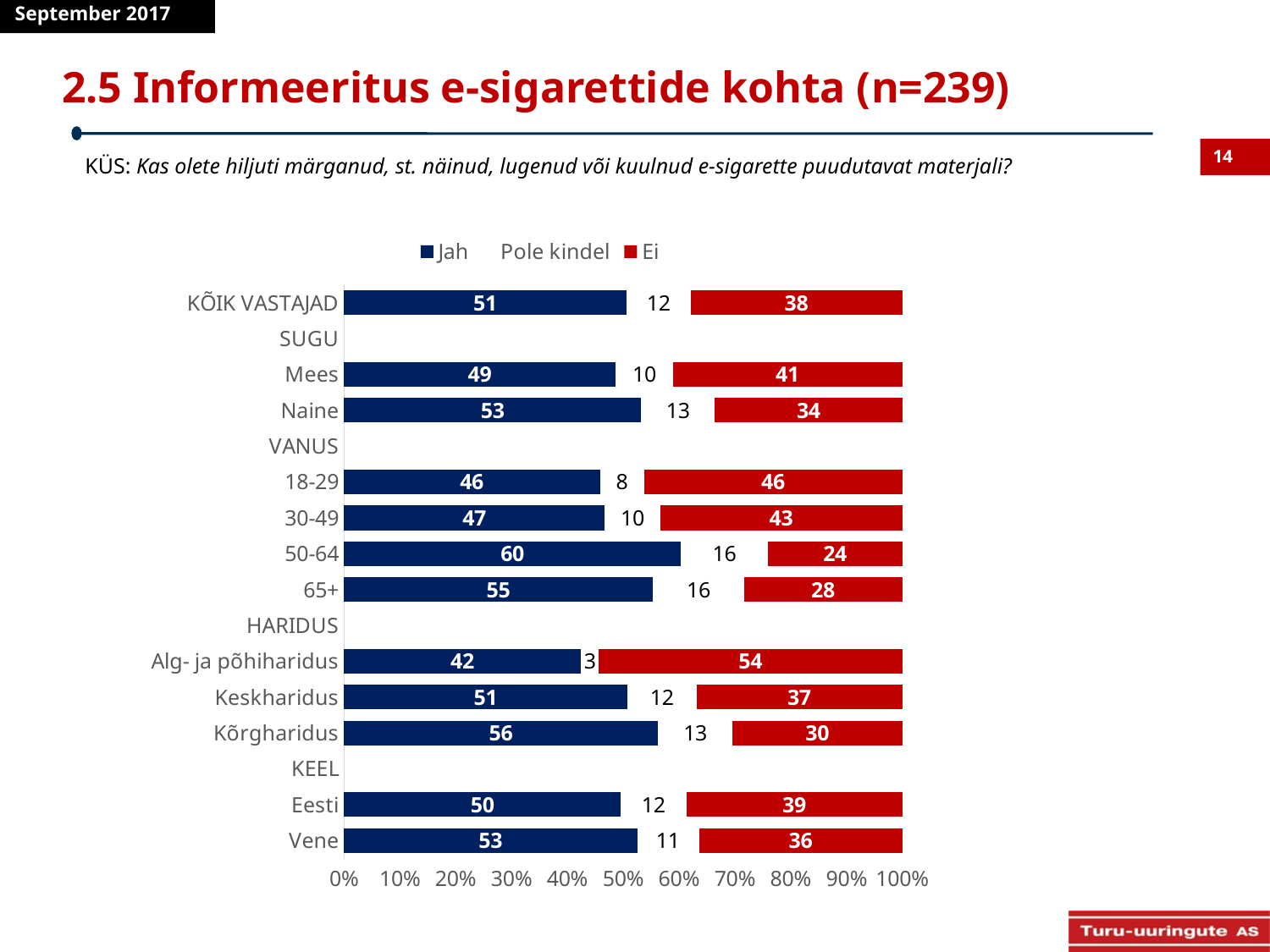
What is the "Jah" value for KÕIK VASTAJAD? 51 What is the "Ei" value for 18-29? 46 What kind of chart is shown on the slide? Stacked bar chart Which category has the highest "Jah" value? 50-64 What is the "Pole kindel" value for 50-64? 16 Which is larger, the "Jah" value for Eesti or for Vene? Vene Which category has the lowest "Pole kindel" value? Alg- ja põhiharidus What is the "Ei" value for Alg- ja põhiharidus? 54 What is the total of the stacked bar for 65+? 99 What is the difference between the "Ei" values for Mees and Naine? 7 Which series is shown in red? Ei How many series does the legend list? 3